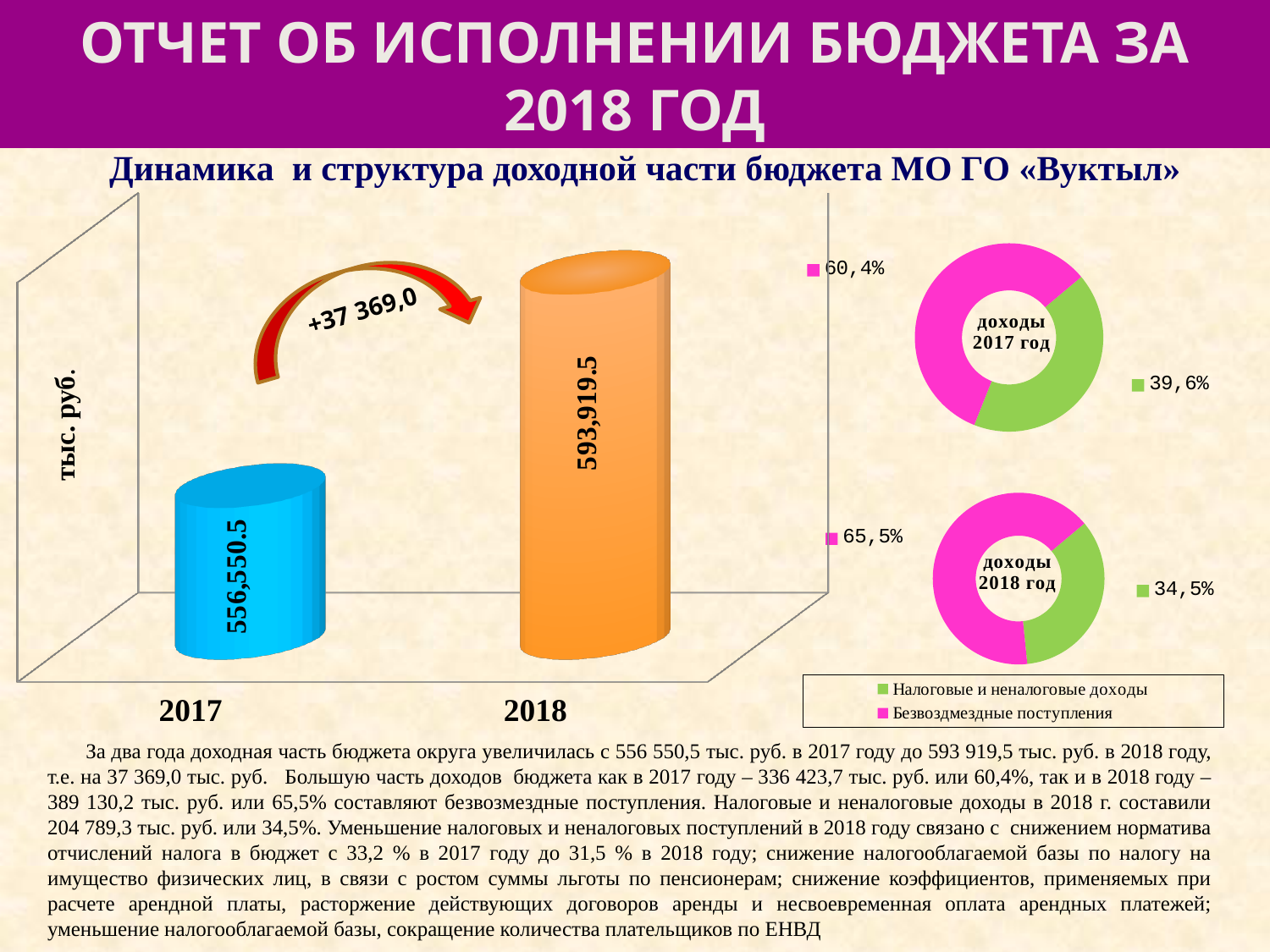
In the bar chart, what is the value for 2017? 556,550.5 In the bar chart, what is the value for 2018? 593,919.5 In the donut chart 'доходы 2017 год', what share is Безвозмездные поступления? 60,4% In the bar chart, do the values rise or fall from 2017 to 2018? rise In the bar chart, which year has the lower value? 2017 In the bar chart, how many years are plotted? 2 What is the unit label on the vertical axis of the bar chart? тыс. руб. In the donut chart 'доходы 2018 год', which category has the larger share? Безвозмездные поступления In the bar chart, which year has the higher value? 2018 In the donut chart 'доходы 2018 год', what share is Налоговые и неналоговые доходы? 34,5% In the bar chart, what is the difference between the 2018 and 2017 values? 37,369.0 What kind of chart is the one on the left showing 2017 and 2018? bar chart